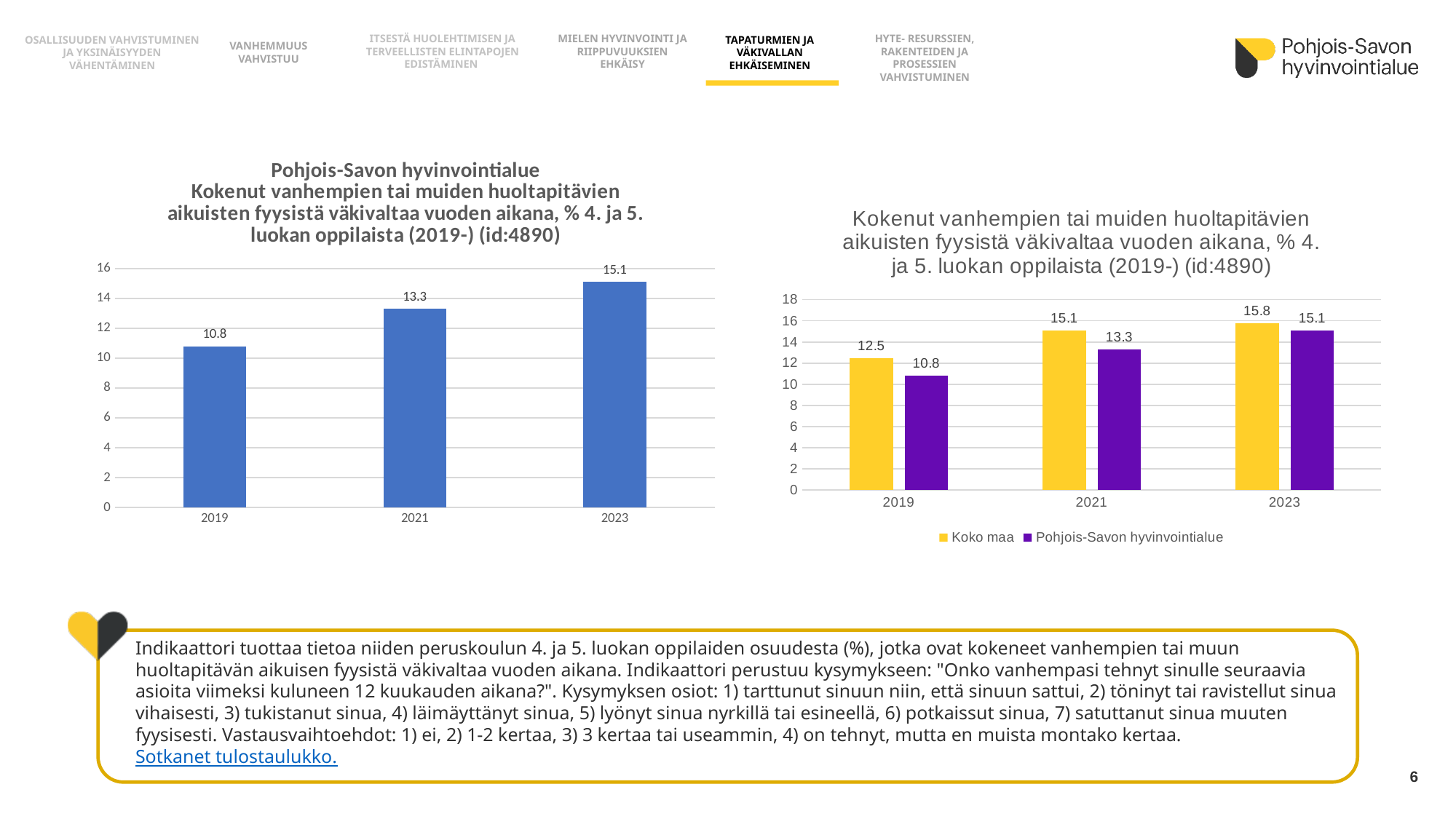
In the left chart, which year has the highest value? 2023 In the right chart, how many series does the legend list? 2 In the left chart, do the values rise or fall from 2019 to 2023? rise In the left chart, which year has the lowest value? 2019 What kind of chart is the right chart? bar chart In the left chart, what is the value for 2021? 13.3 In the right chart, which is larger in 2021: Koko maa or Pohjois-Savon hyvinvointialue? Koko maa In the right chart, what is the value for Pohjois-Savon hyvinvointialue in 2023? 15.1 In the right chart, what is the difference between Koko maa and Pohjois-Savon hyvinvointialue in 2019? 1.7 In the left chart, how many years are plotted? 3 In the left chart, what is the difference between the 2023 and 2019 values? 4.3 In the right chart, what is the value for Koko maa in 2019? 12.5